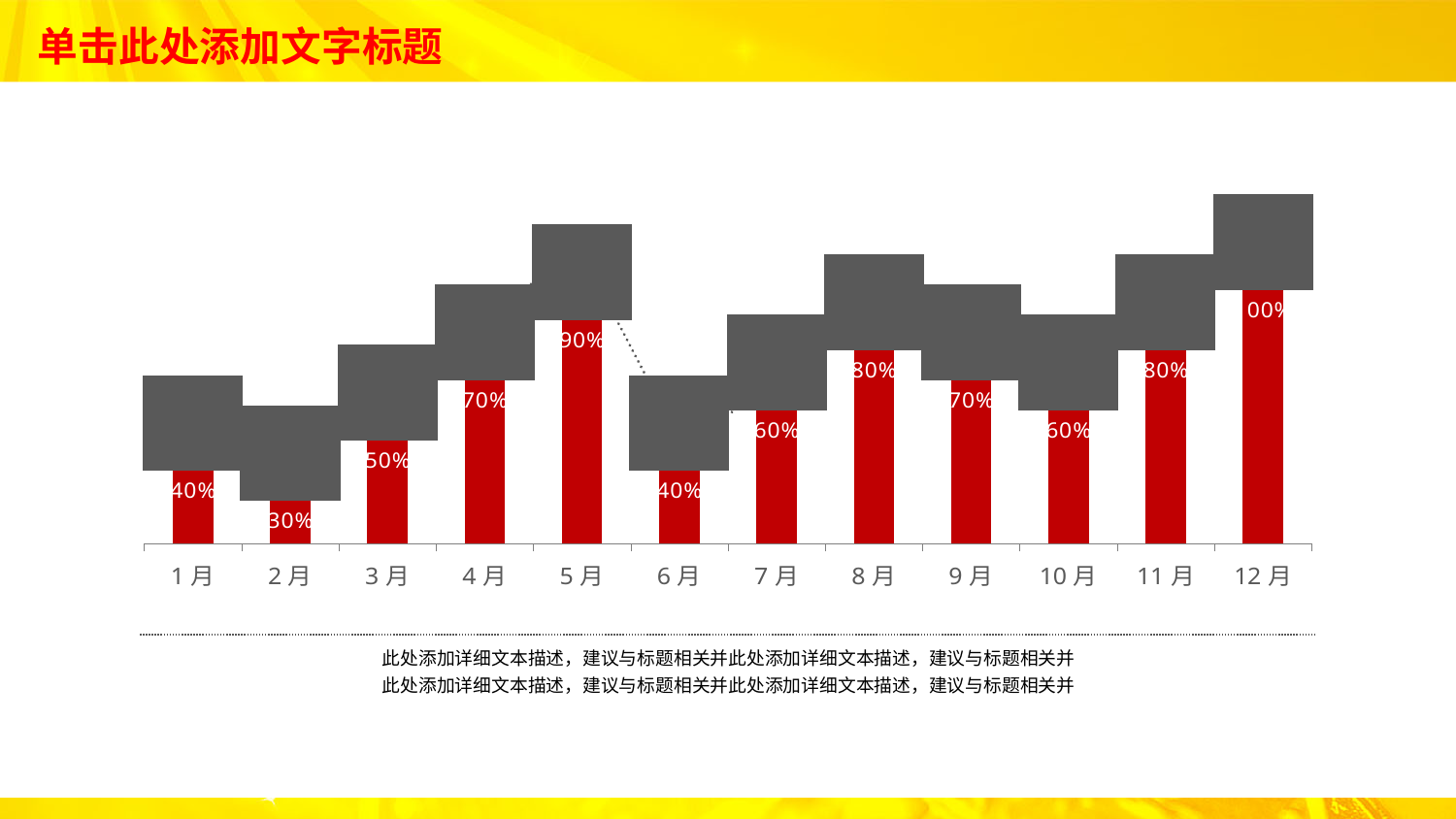
What is the difference between the values for 5月 and 6月? 50% Which month has the lowest value? 2月 What kind of chart is shown on the slide? bar chart What is the value for 10月? 60% Which month has the highest bar? 12月 How many months are shown on the x axis? 12 Which is larger, the value for 4月 or the value for 7月? 4月 What is the value for 8月? 80% What is the value for 1月? 40% What is the difference between the values for 3月 and 2月? 20% What is the value for 5月? 90%